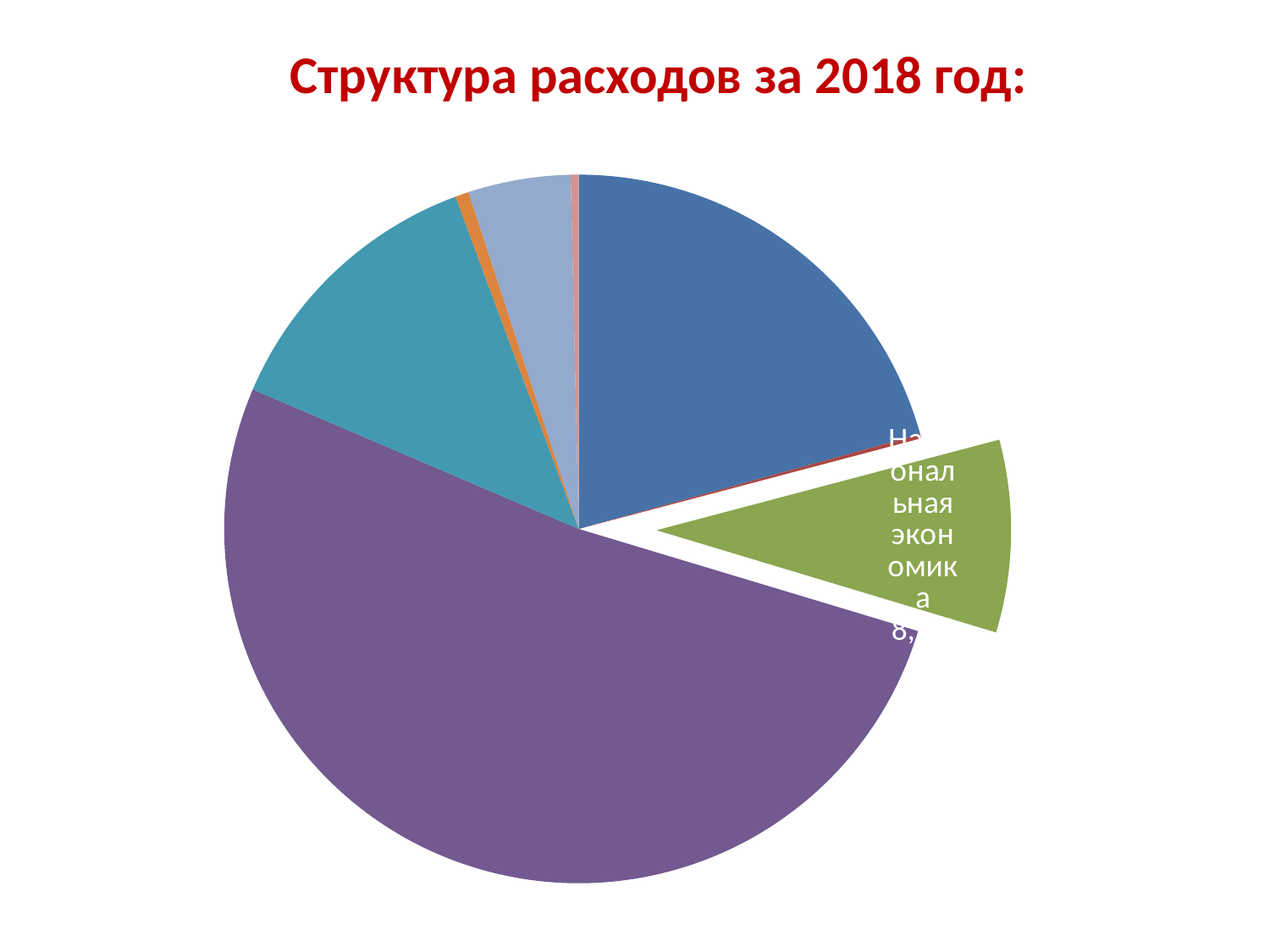
What kind of chart is shown on the slide? Pie chart Which category is labelled on the slice that is pulled out from the pie? Национальная экономика What is the title of the chart? Структура расходов за 2018 год: Which colour slice is the largest in the pie? Purple Which is larger, the green exploded slice or the purple slice? Purple Which is larger, the blue slice or the teal slice? Blue How many slices does the pie chart have? 8 Which is larger, the purple slice or the blue slice? Purple